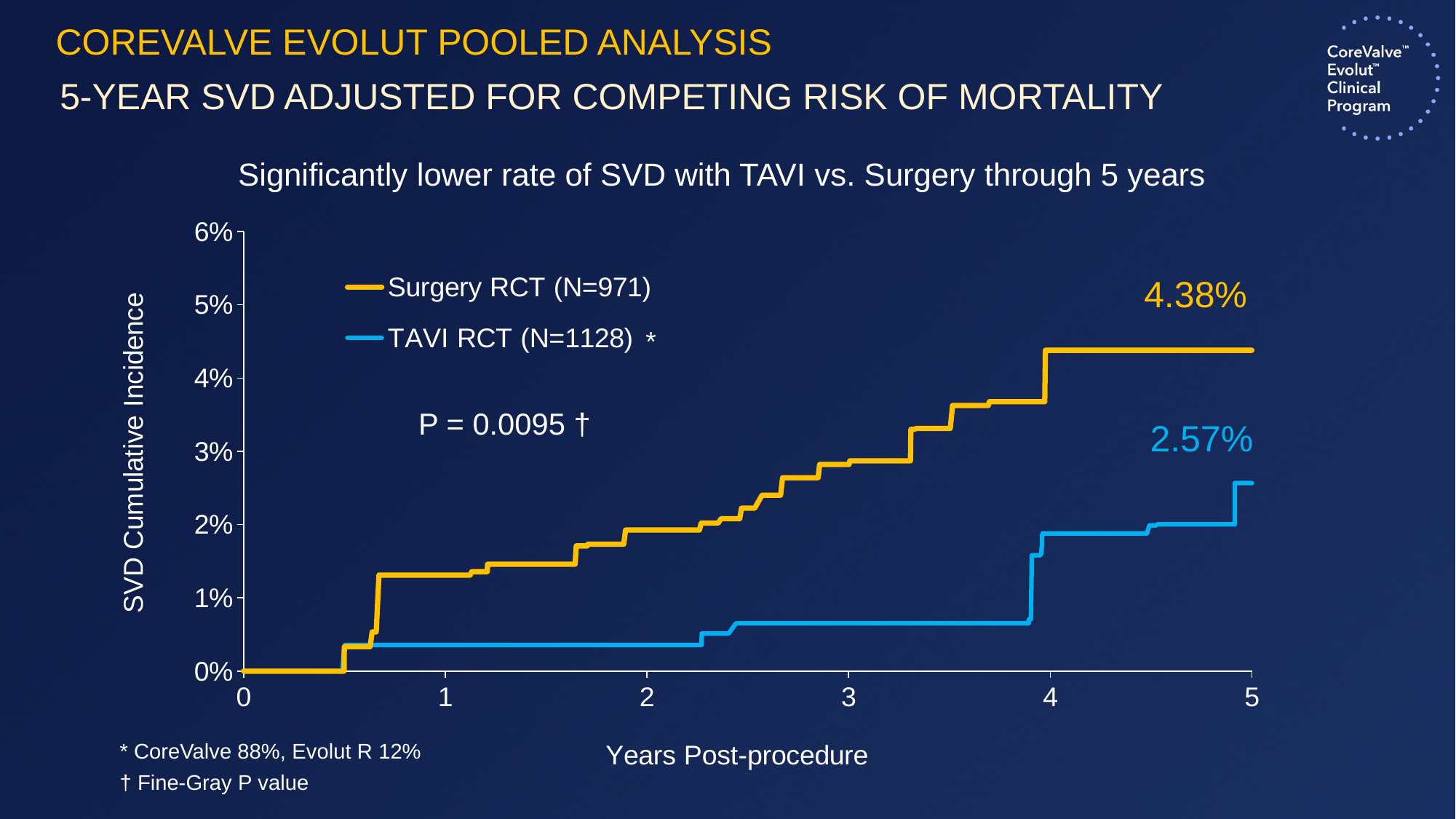
What is the label of the x axis? Years Post-procedure What is the sample size (N) of the Surgery RCT group shown in the legend? 971 How many series does the legend list? 2 Does the SVD cumulative incidence for Surgery RCT rise or fall over the years post-procedure? Rise What P value is shown on the chart? P = 0.0095 Which group has the higher SVD cumulative incidence at 5 years? Surgery RCT What is the 5-year SVD cumulative incidence for the TAVI RCT group? 2.57% Is the SVD cumulative incidence for Surgery RCT at year 3 greater or less than 2%? greater What kind of chart is shown on the slide? Line chart What is the difference between the 5-year SVD cumulative incidence of Surgery RCT and TAVI RCT? 1.81% Is the SVD cumulative incidence for TAVI RCT at year 3 greater or less than 1%? less What is the 5-year SVD cumulative incidence for the Surgery RCT group? 4.38%